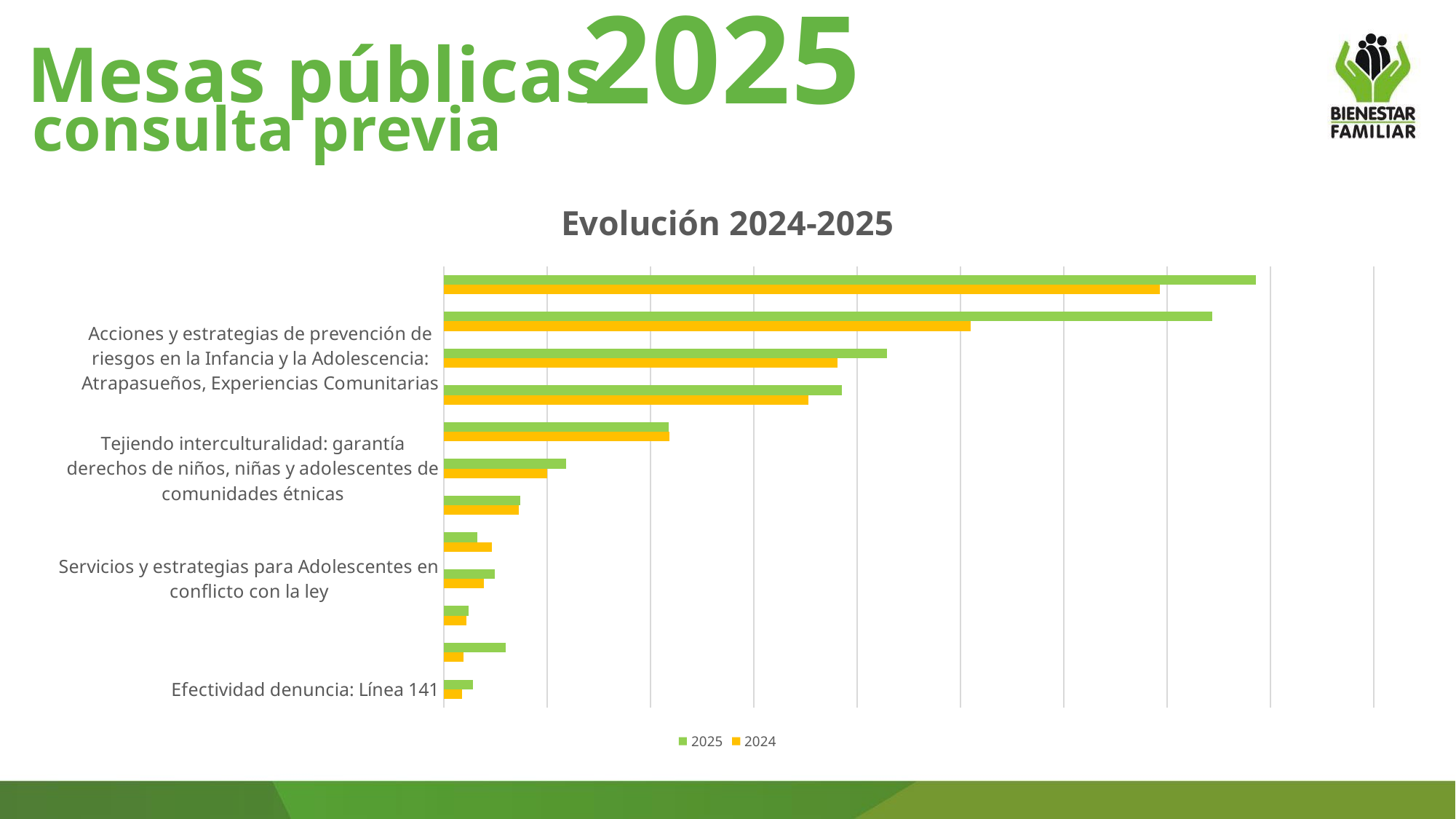
How many categories (pairs of bars) are plotted in the chart? 12 Which two series are listed in the chart legend? 2025 and 2024 How many series does the legend of the chart list? 2 What kind of chart is shown on the slide? bar chart Do the bar lengths generally increase or decrease going from the top of the chart to the bottom? decrease Which series is drawn in green in the chart? 2025 For the topmost category in the chart, which series has the longer bar, 2025 or 2024? 2025 What is the title of the chart? Evolución 2024-2025 For the category 'Efectividad denuncia: Línea 141', which series has the longer bar, 2025 or 2024? 2025